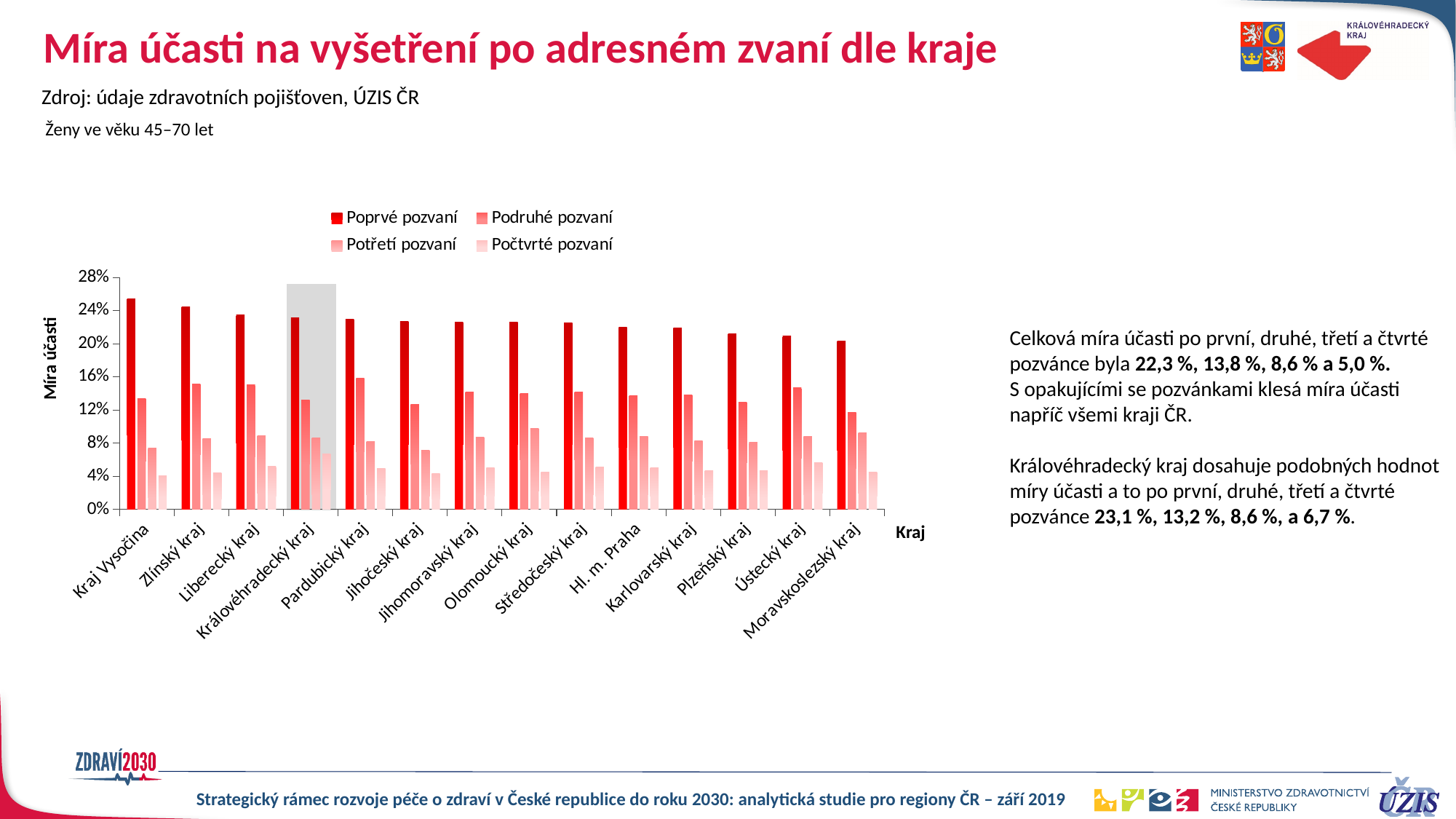
Which region is highlighted with a grey background in the chart? Královéhradecký kraj How many regions (kraje) are shown on the x axis of the chart? 14 Is the Poprvé pozvaní value for Kraj Vysočina greater or less than 24%? greater Which region has the lowest value for Poprvé pozvaní? Moravskoslezský kraj According to the slide, what is the participation rate for Královéhradecký kraj after the first invitation (Poprvé pozvaní)? 23,1 % According to the slide, what is the participation rate for Královéhradecký kraj after the fourth invitation (Počtvrté pozvaní)? 6,7 % How many series does the chart legend list? 4 Within each region, do the values rise or fall from the first invitation to the fourth invitation? fall Is the Podruhé pozvaní value for Pardubický kraj greater or less than 12%? greater Which is larger: the Podruhé pozvaní value for Pardubický kraj or for Kraj Vysočina? Pardubický kraj Which region has the highest value for Poprvé pozvaní? Kraj Vysočina What kind of chart is shown on the slide? bar chart